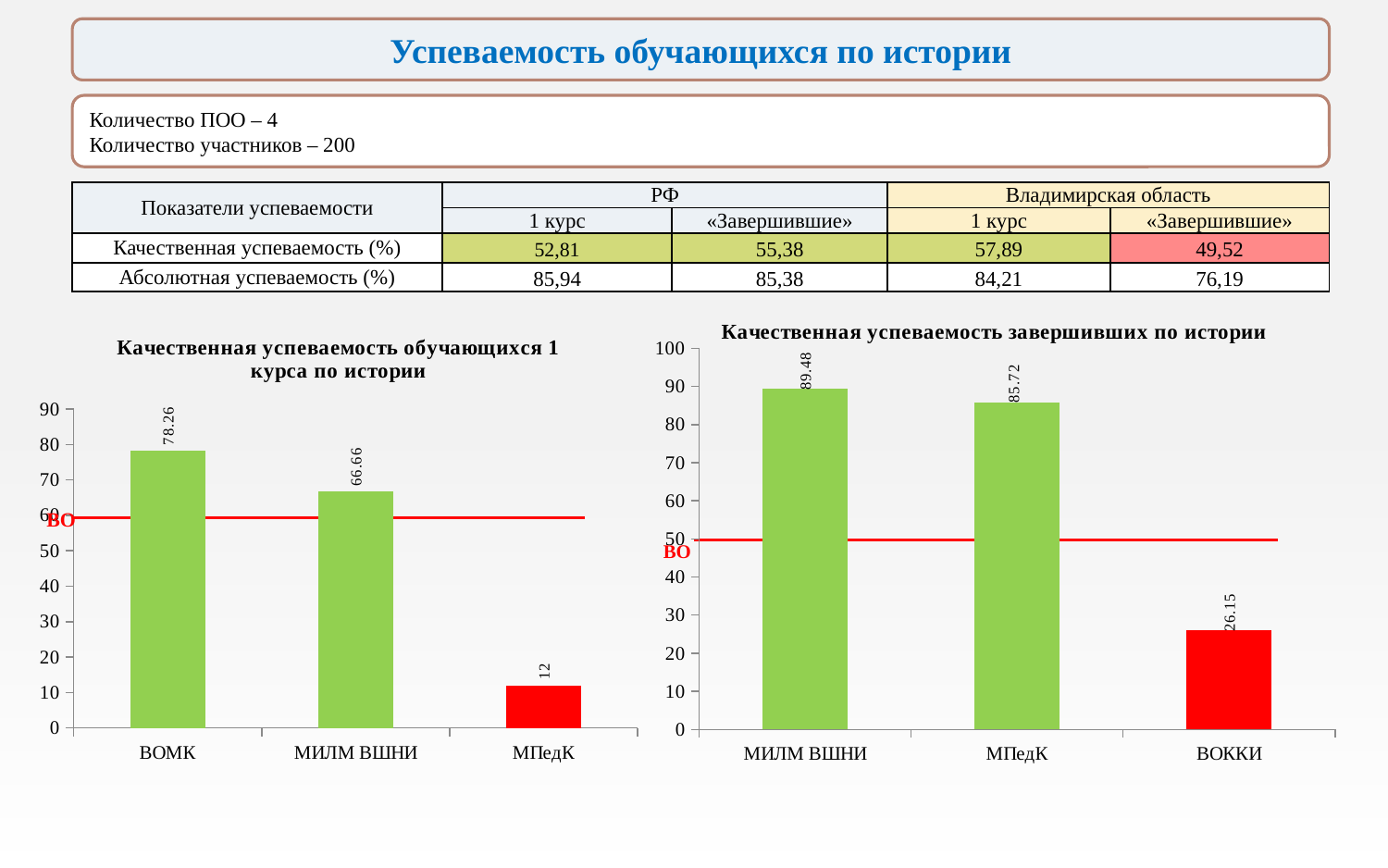
In the chart 'Качественная успеваемость обучающихся 1 курса по истории', which category has the highest value? ВОМК In the chart 'Качественная успеваемость завершивших по истории', what is the value for ВОККИ? 26.15 In the chart 'Качественная успеваемость обучающихся 1 курса по истории', how many categories are shown on the x axis? 3 What kind of chart is 'Качественная успеваемость завершивших по истории'? bar chart In the chart 'Качественная успеваемость завершивших по истории', what is the difference between the values for МПедК and ВОККИ? 59.57 In the chart 'Качественная успеваемость обучающихся 1 курса по истории', what is the value for МПедК? 12 In the chart 'Качественная успеваемость обучающихся 1 курса по истории', what is the value for ВОМК? 78.26 In the chart 'Качественная успеваемость завершивших по истории', which category has the lowest value? ВОККИ In the chart 'Качественная успеваемость завершивших по истории', which is larger, the value for МИЛМ ВШНИ or the value for МПедК? МИЛМ ВШНИ In the chart 'Качественная успеваемость обучающихся 1 курса по истории', what is the difference between the values for ВОМК and МИЛМ ВШНИ? 11.6 In the chart 'Качественная успеваемость завершивших по истории', what is the value for МИЛМ ВШНИ? 89.48 In the chart 'Качественная успеваемость обучающихся 1 курса по истории', what colour is the bar for МПедК? red